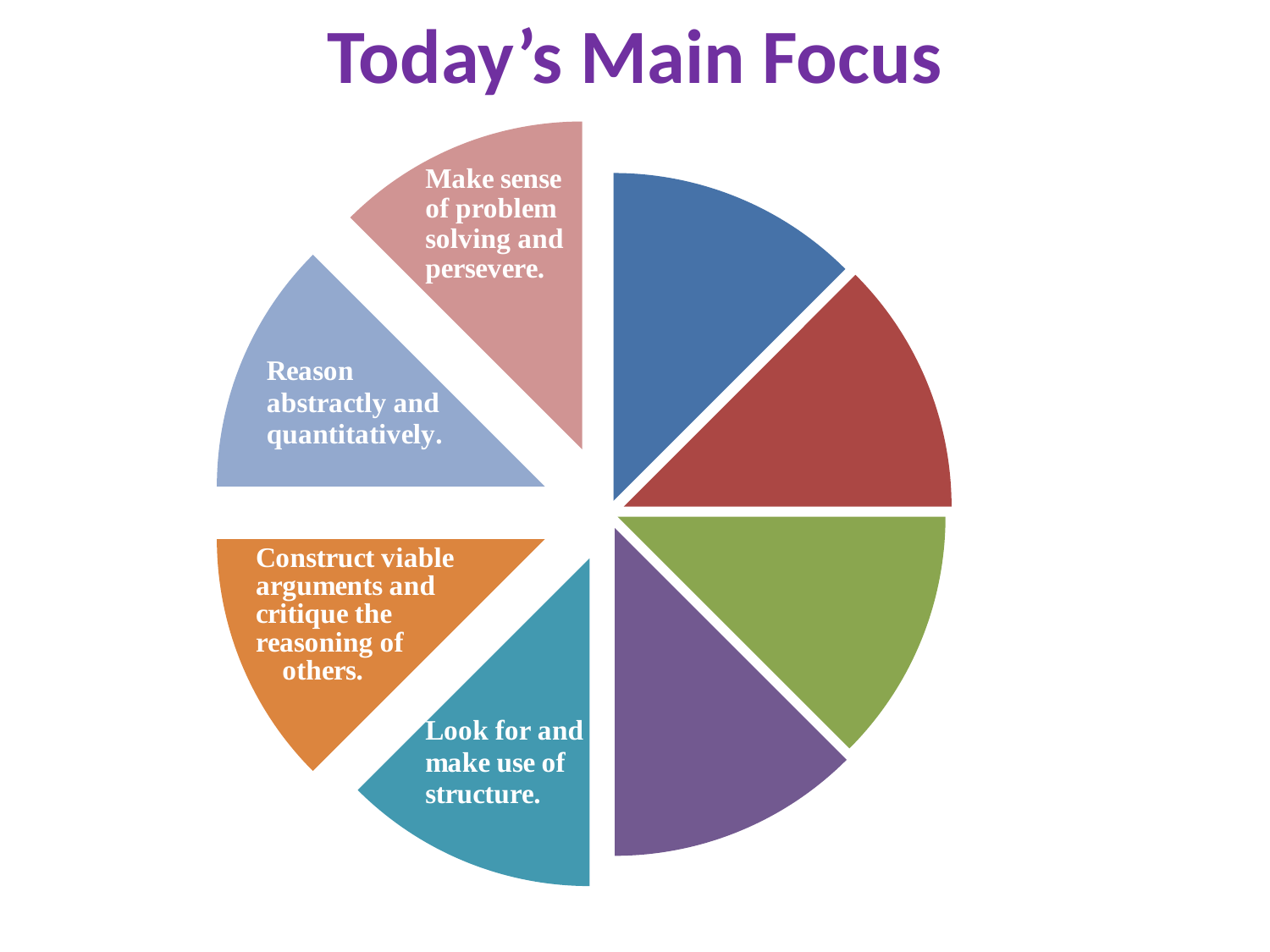
How many slices does the pie chart have? 8 What kind of chart is shown on the slide? pie chart Which slice label appears on the pink slice at the top left of the pie chart? Make sense of problem solving and persevere. What colour is the slice labelled "Look for and make use of structure."? teal How many slices of the pie chart carry a text label? 4 Which slice label appears on the light blue slice on the left of the pie chart? Reason abstractly and quantitatively. Which slice label appears on the orange slice of the pie chart? Construct viable arguments and critique the reasoning of others. Are the labelled slices of the pie chart on the left or the right side of the chart? left What is the title of the slide containing the pie chart? Today's Main Focus